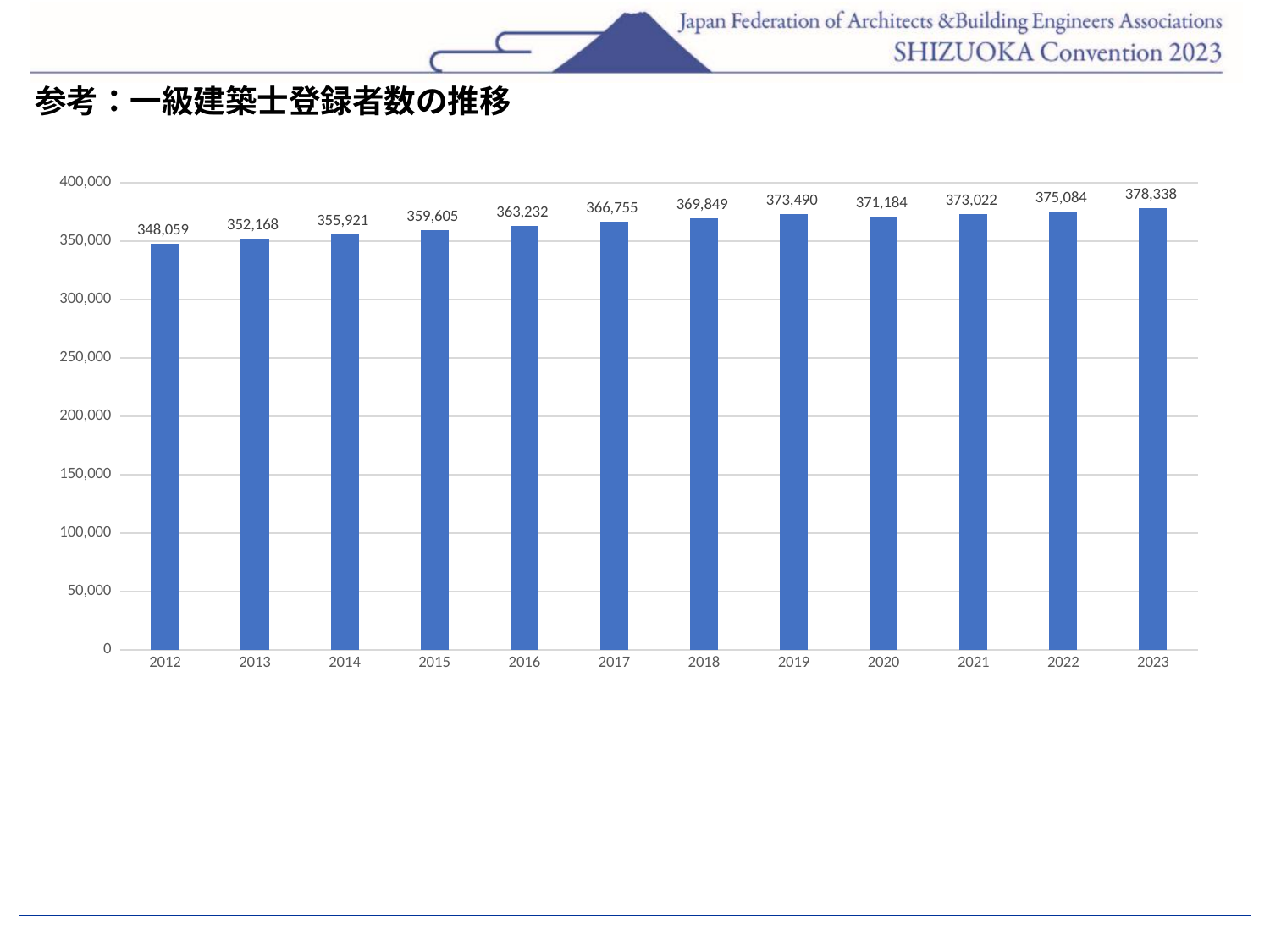
What is the difference between the values for 2023 and 2012? 30,279 What is the value for 2023? 378,338 Which year has the highest value? 2023 How many years are shown on the x axis? 12 Which year has the lowest value? 2012 What is the value for 2012? 348,059 Is the value for 2015 greater or less than 350,000? greater What is the value for 2020? 371,184 Do the values generally rise or fall from 2012 to 2023? rise What is the difference between the values for 2019 and 2020? 2,306 Which is larger, the value for 2019 or the value for 2020? 2019 What kind of chart is shown on the slide? bar chart